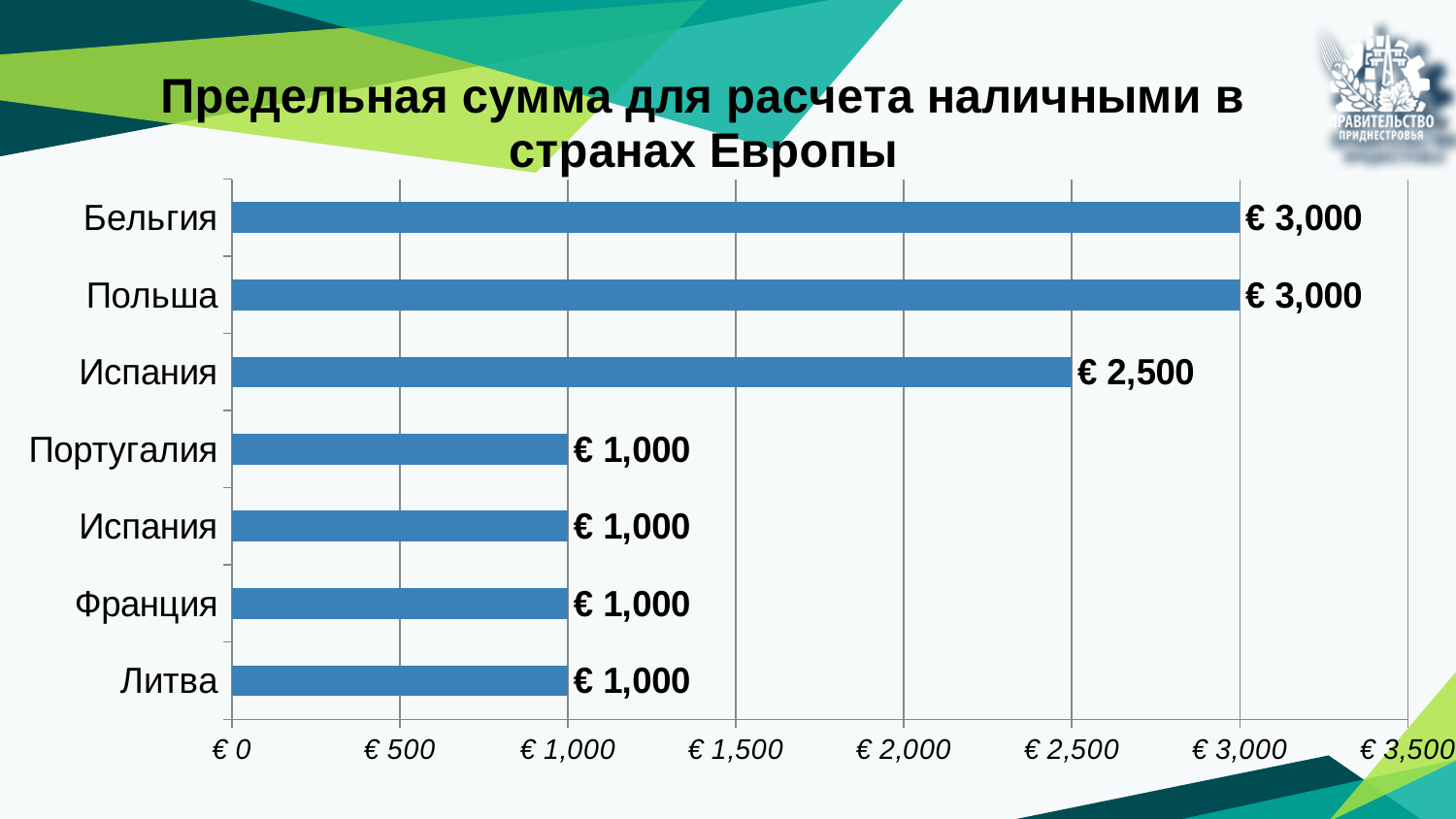
What is the title of the chart? Предельная сумма для расчета наличными в странах Европы What is the value shown for Польша? € 3,000 What is the value shown for Португалия? € 1,000 What is the cash payment limit shown for Бельгия? € 3,000 What kind of chart is shown on the slide? bar chart What is the difference between the values for Бельгия and Португалия? € 2,000 How many bars are plotted on the chart? 7 What is the value shown for Литва? € 1,000 Is the value for Литва greater or less than € 1,500? less What is the value shown for Франция? € 1,000 Which two countries share the highest value on the chart? Бельгия and Польша Which is larger, the value for Польша or the value for Франция? Польша